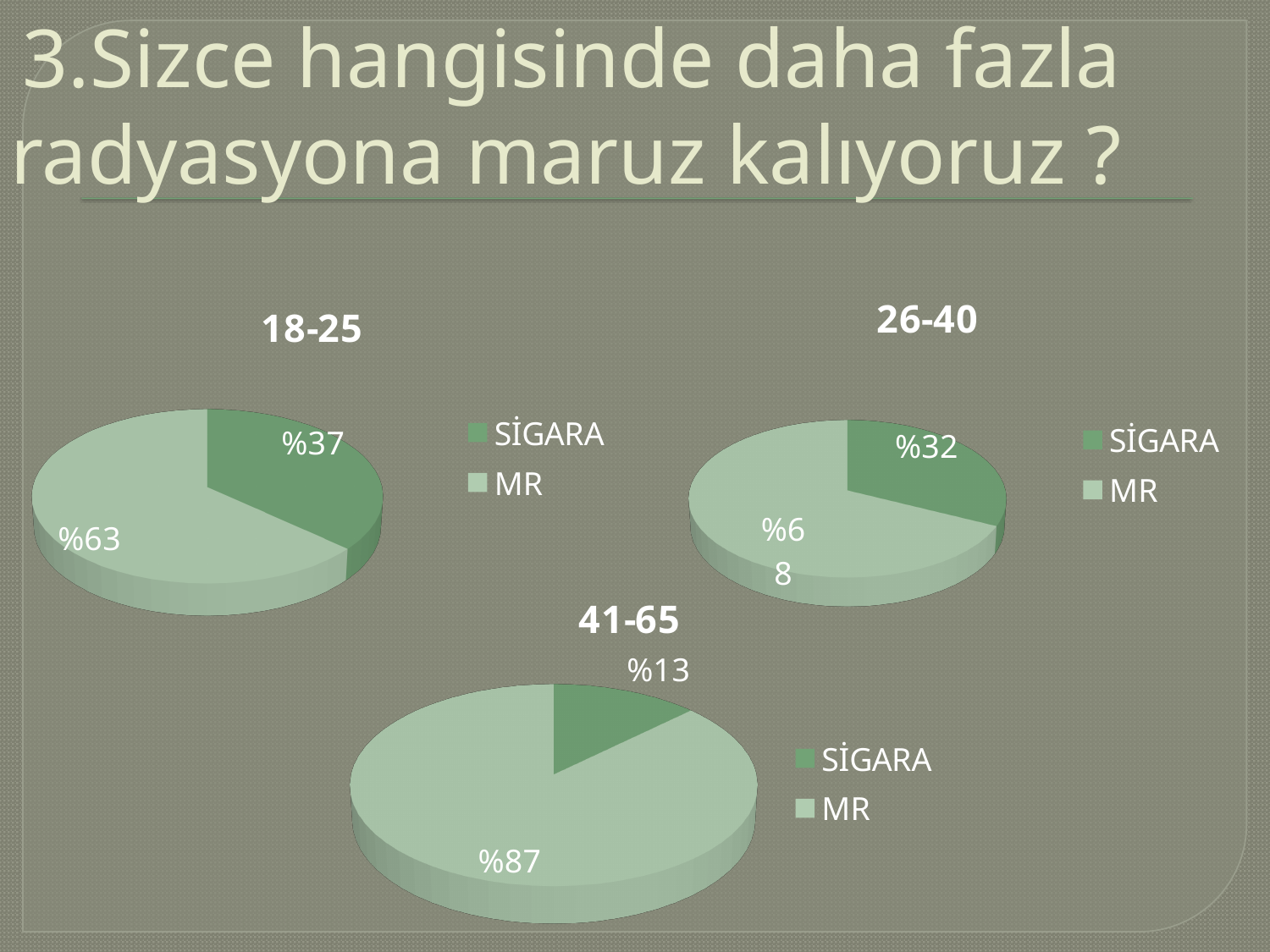
In the 18-25 chart, what percentage is shown for MR? %63 In the 26-40 chart, what percentage is shown for SİGARA? %32 How many pie charts are shown on the slide? 3 How many entries does the legend of the 41-65 chart list? 2 In the 18-25 chart, what percentage is shown for SİGARA? %37 What kind of chart is the 26-40 chart? Pie chart In the 41-65 chart, what is the difference between the MR and SİGARA percentages? %74 In the 18-25 chart, which slice is larger, SİGARA or MR? MR In the 18-25 chart, what is the difference between the MR and SİGARA percentages? %26 In the 41-65 chart, what percentage is shown for MR? %87 In the 41-65 chart, which category has the smallest slice? SİGARA In the 41-65 chart, what percentage is shown for SİGARA? %13